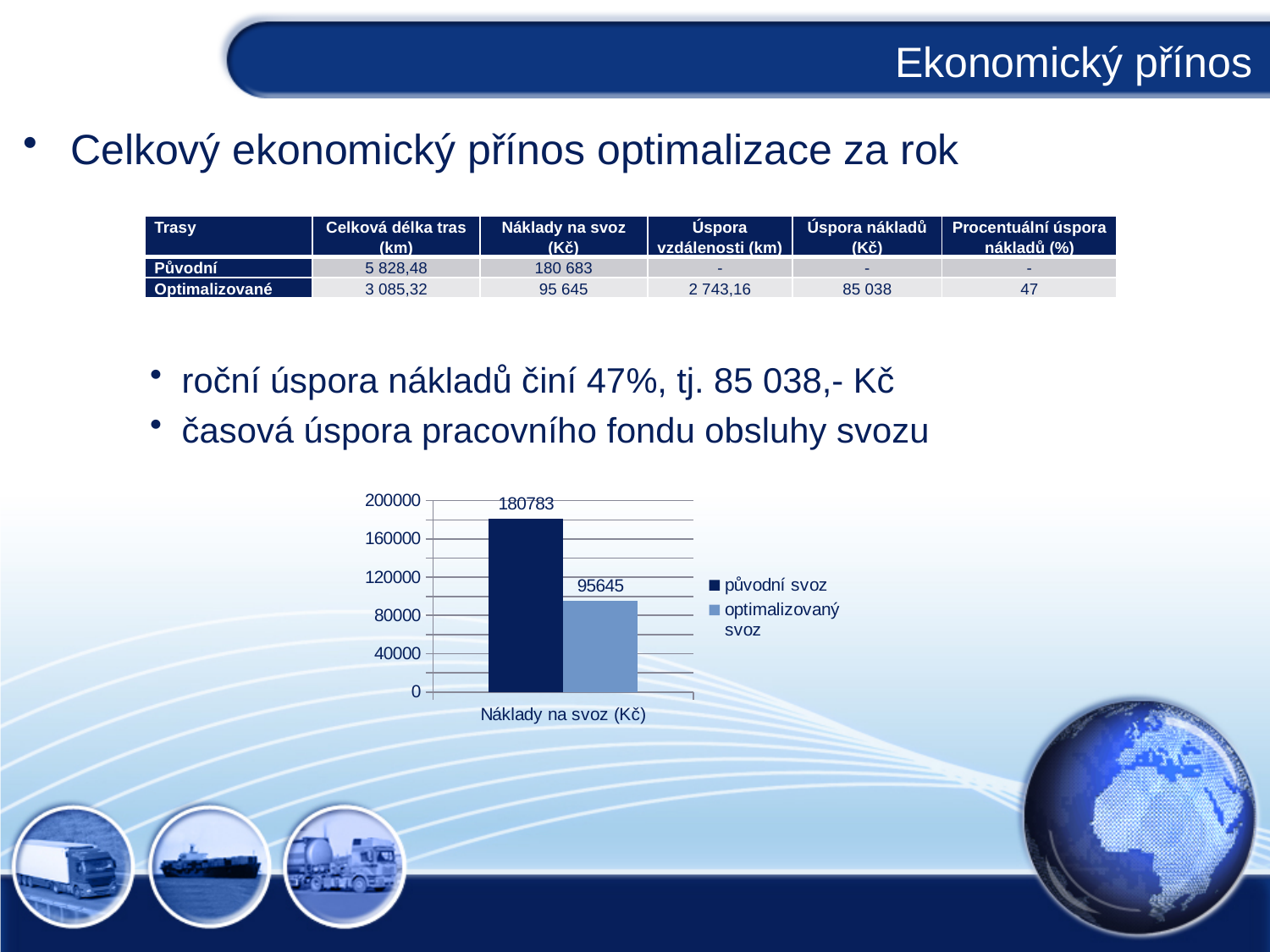
Is the value for 'optimalizovaný svoz' greater or less than 120000? less Which series has the highest value in the chart? původní svoz Is the value for 'původní svoz' greater or less than 160000? greater Which series has the higher value in the chart, 'původní svoz' or 'optimalizovaný svoz'? původní svoz How many series does the chart legend list? 2 What is the value of the 'původní svoz' bar in the chart? 180783 How many categories are shown on the x axis of the chart? 1 Which series has the lowest value in the chart? optimalizovaný svoz What is the value of the 'optimalizovaný svoz' bar in the chart? 95645 What kind of chart is shown on the slide? bar chart What is the maximum value shown on the y axis of the chart? 200000 What is the category label shown on the x axis of the chart? Náklady na svoz (Kč)